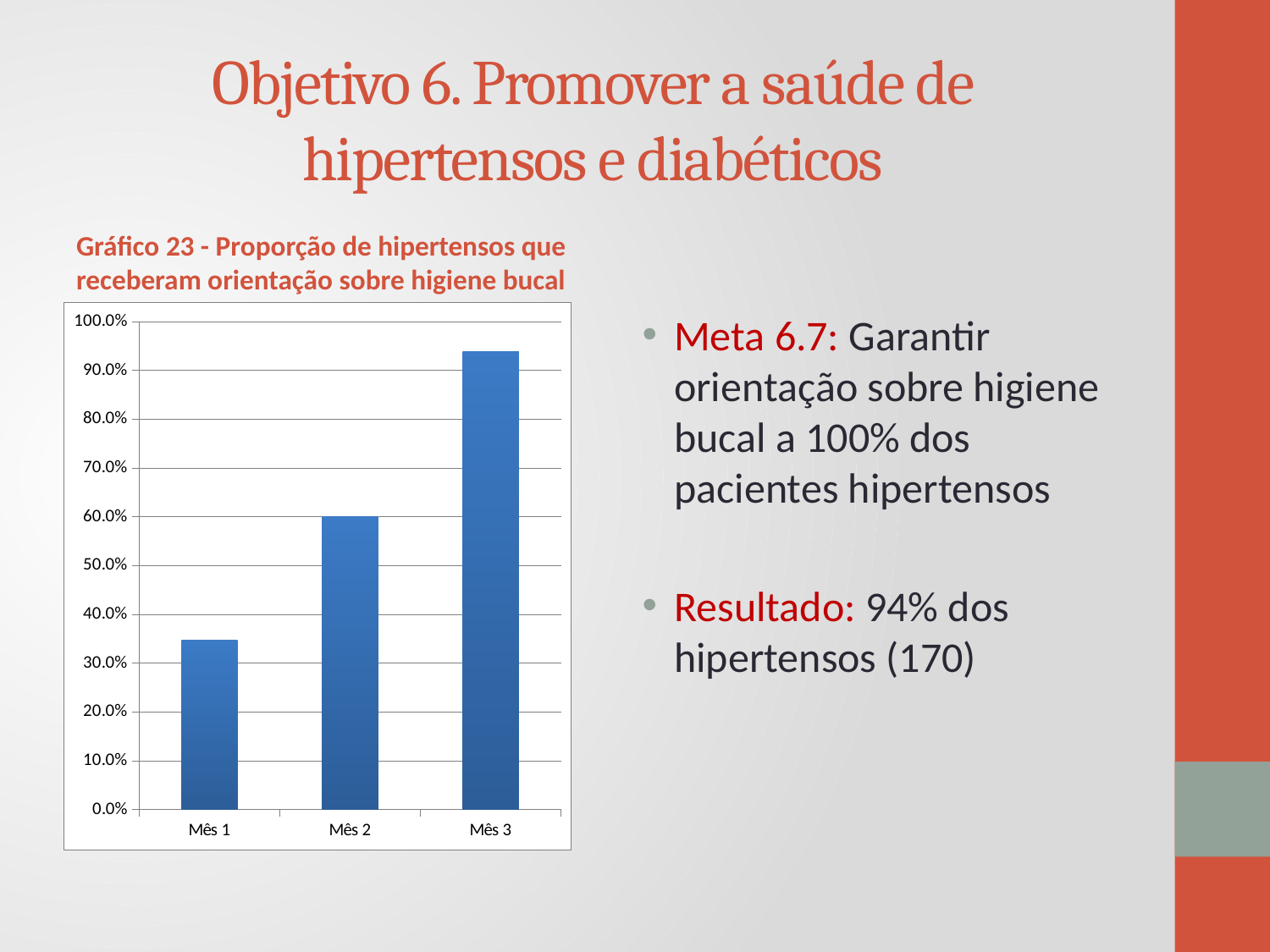
What kind of chart is shown on the slide? bar chart Which month has the lowest proportion in the chart? Mês 1 Is the value for Mês 3 greater or less than 90.0%? greater Is the value for Mês 1 greater or less than 30.0%? greater Is the value for Mês 1 greater or less than 40.0%? less Which month has the highest proportion in the chart? Mês 3 Do the values rise or fall from Mês 1 to Mês 3? rise How many categories are shown on the x axis of the chart? 3 What is the title of the chart? Gráfico 23 - Proporção de hipertensos que receberam orientação sobre higiene bucal Which is larger, the value for Mês 2 or the value for Mês 3? Mês 3 What is the maximum value shown on the y axis of the chart? 100.0%